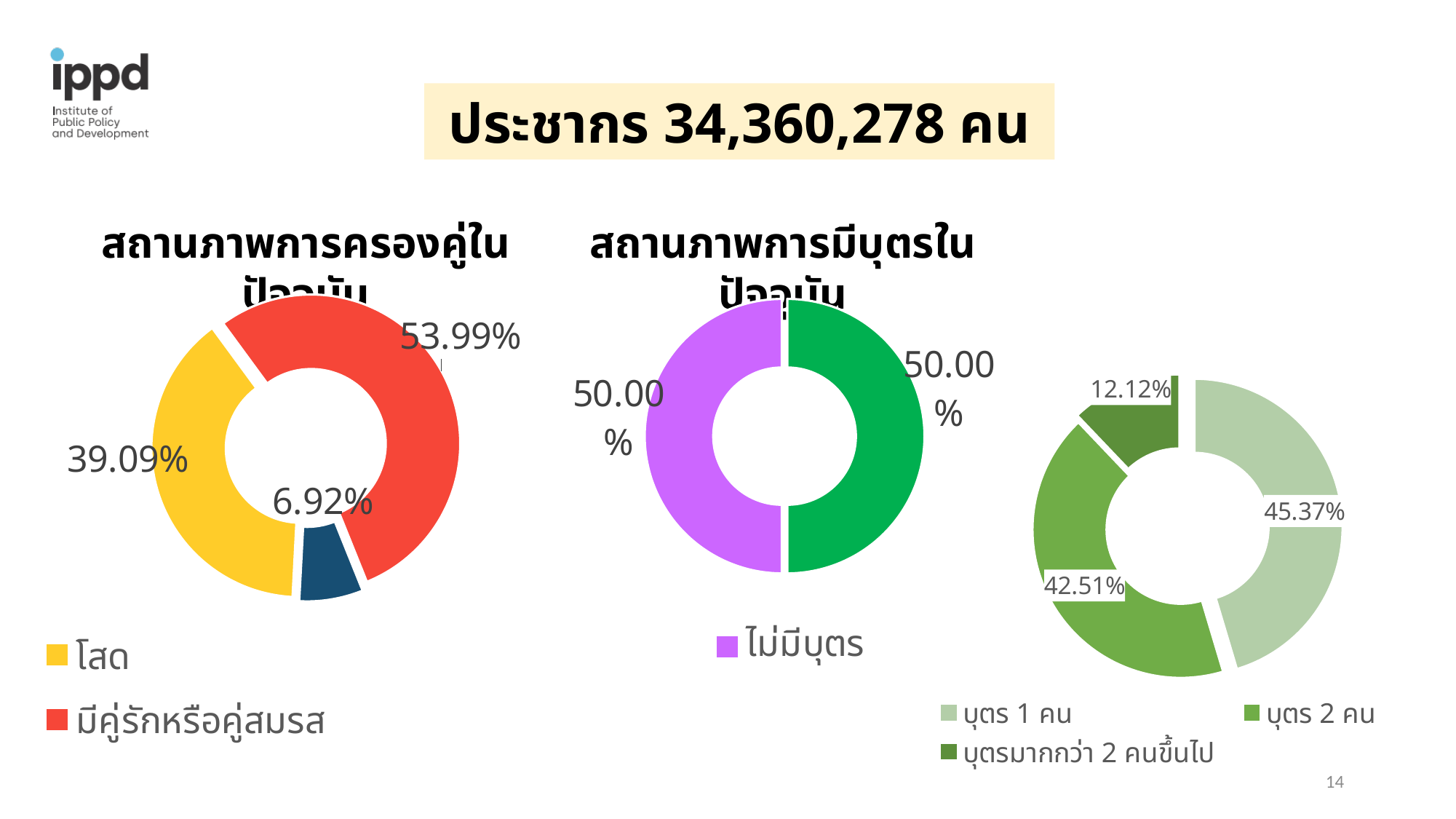
In the chart titled สถานภาพการครองคู่ในปัจจุบัน, what is the difference in percentage points between มีคู่รักหรือคู่สมรส and โสด? 14.90 In the rightmost chart on the slide, what percentage is shown for บุตร 1 คน? 45.37% In the rightmost chart on the slide, which is larger: บุตร 1 คน or บุตร 2 คน? บุตร 1 คน In the chart titled สถานภาพการมีบุตรในปัจจุบัน, how many slices does the donut have? 2 In the chart titled สถานภาพการครองคู่ในปัจจุบัน, what percentage is shown for มีคู่รักหรือคู่สมรส? 53.99% What kind of chart is the rightmost chart on the slide? Donut (pie) chart In the rightmost chart on the slide, which category has the smallest share? บุตรมากกว่า 2 คนขึ้นไป In the chart titled สถานภาพการมีบุตรในปัจจุบัน, what percentage is shown for ไม่มีบุตร? 50.00% In the rightmost chart on the slide, what percentage is shown for บุตรมากกว่า 2 คนขึ้นไป? 12.12% In the chart titled สถานภาพการครองคู่ในปัจจุบัน, how many slices does the donut have? 3 In the chart titled สถานภาพการครองคู่ในปัจจุบัน, what percentage is shown for โสด? 39.09% In the chart titled สถานภาพการครองคู่ในปัจจุบัน, which legend category has the largest share? มีคู่รักหรือคู่สมรส